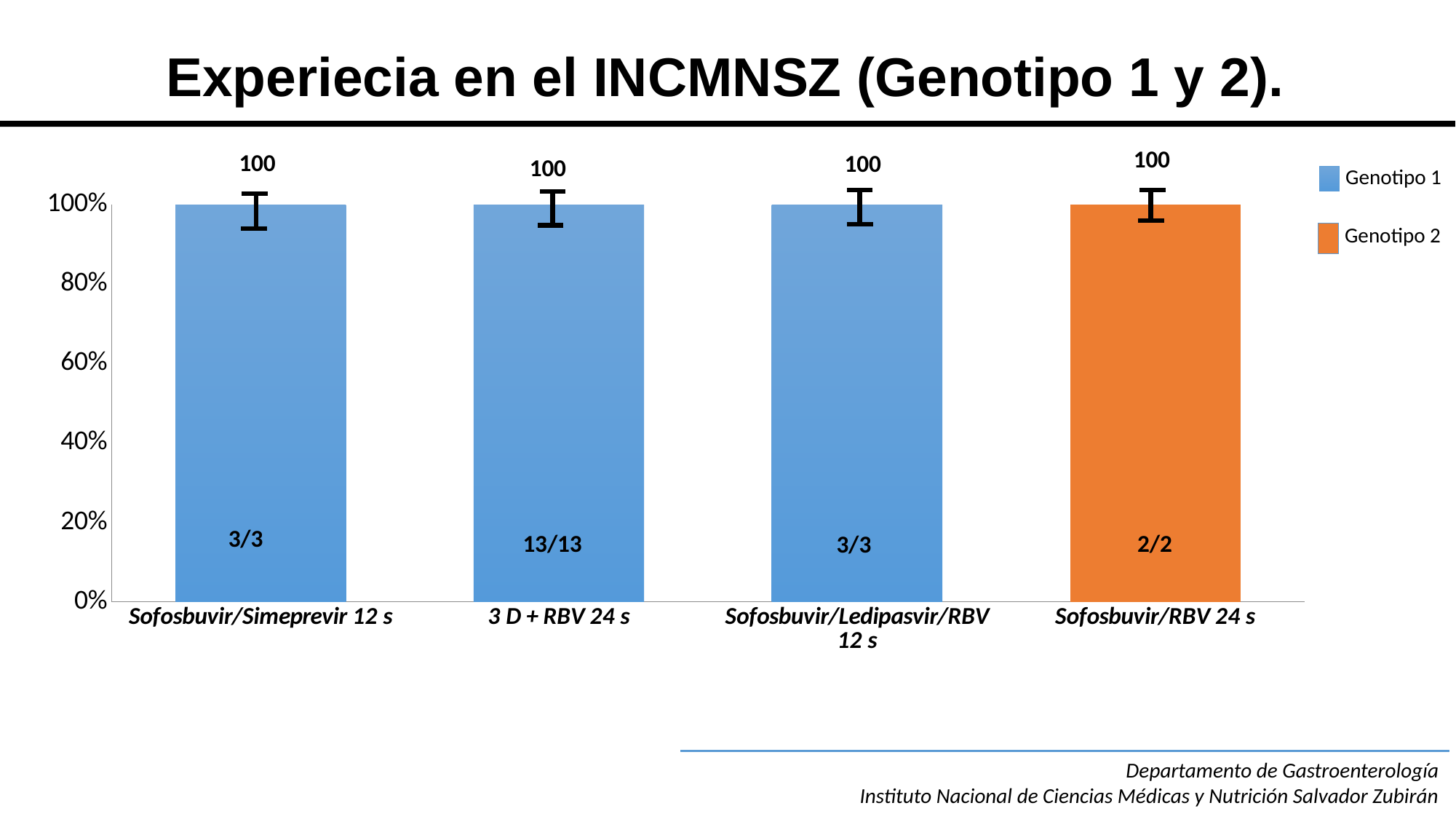
What is the title of the slide containing the chart? Experiecia en el INCMNSZ (Genotipo 1 y 2). What fraction is printed inside the bar for Sofosbuvir/RBV 24 s? 2/2 Which series does the orange bar belong to according to the legend? Genotipo 2 What value is labelled above the bar for Sofosbuvir/Simeprevir 12 s? 100 Is the value for 3 D + RBV 24 s greater or less than 80%? greater What fraction is printed inside the bar for Sofosbuvir/Ledipasvir/RBV 12 s? 3/3 How many bars (treatment categories) are shown in the chart? 4 How many series does the legend list? 2 What fraction is printed inside the bar for 3 D + RBV 24 s? 13/13 What value is labelled above the bar for 3 D + RBV 24 s? 100 What is the difference between the labelled values for Sofosbuvir/Simeprevir 12 s and Sofosbuvir/RBV 24 s? 0 What kind of chart is shown on the slide? bar chart